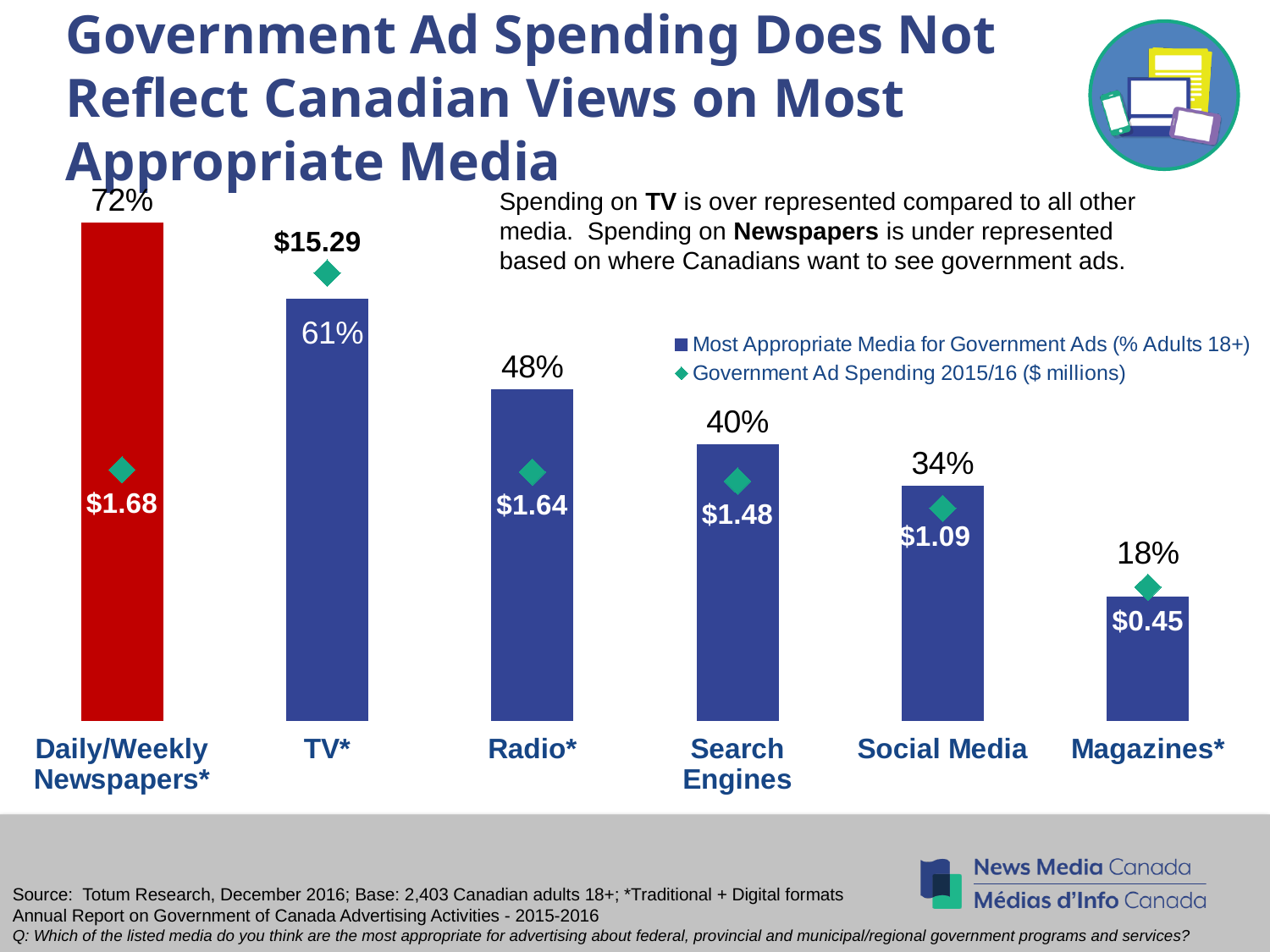
What percentage of adults consider Daily/Weekly Newspapers the most appropriate media for government ads? 72% Which bar is coloured red on the chart? Daily/Weekly Newspapers Which had higher government ad spending in 2015/16, Radio or Social Media? Radio Which media category has the lowest government ad spending in 2015/16? Magazines What was government ad spending on Magazines in 2015/16? $0.45 Which media category has the highest percentage of adults rating it most appropriate for government ads? Daily/Weekly Newspapers What kind of chart is used to show the most appropriate media percentages? Bar chart How many media categories are shown on the chart? 6 How many series does the legend list? 2 What was government ad spending on TV in 2015/16, in $ millions? $15.29 Do the most appropriate media percentages rise or fall from left to right across the categories? Fall What is the difference in percentage points between Radio and Search Engines for most appropriate media? 8